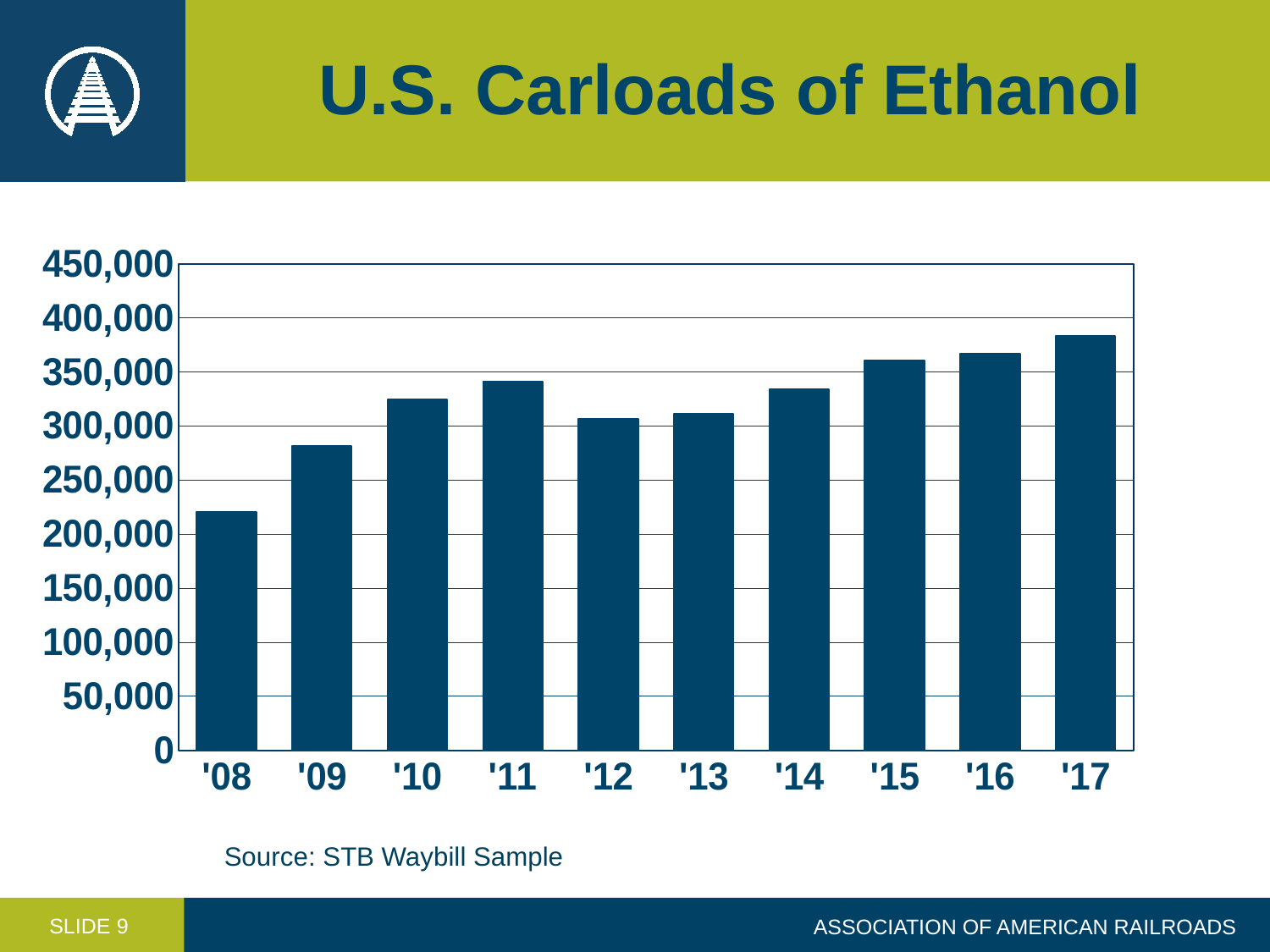
Is the value for '15 greater or less than 350,000? greater How many years are plotted on the chart? 10 Is the value for '17 greater or less than 350,000? greater What is the source cited for the chart data? STB Waybill Sample What kind of chart is shown on the slide? bar chart Is the value for '08 greater or less than 250,000? less Which year has the highest number of U.S. carloads of ethanol? '17 Which year has more carloads of ethanol, '11 or '12? '11 Which year has the lowest number of U.S. carloads of ethanol? '08 Overall, do U.S. carloads of ethanol rise or fall from '08 to '17? rise